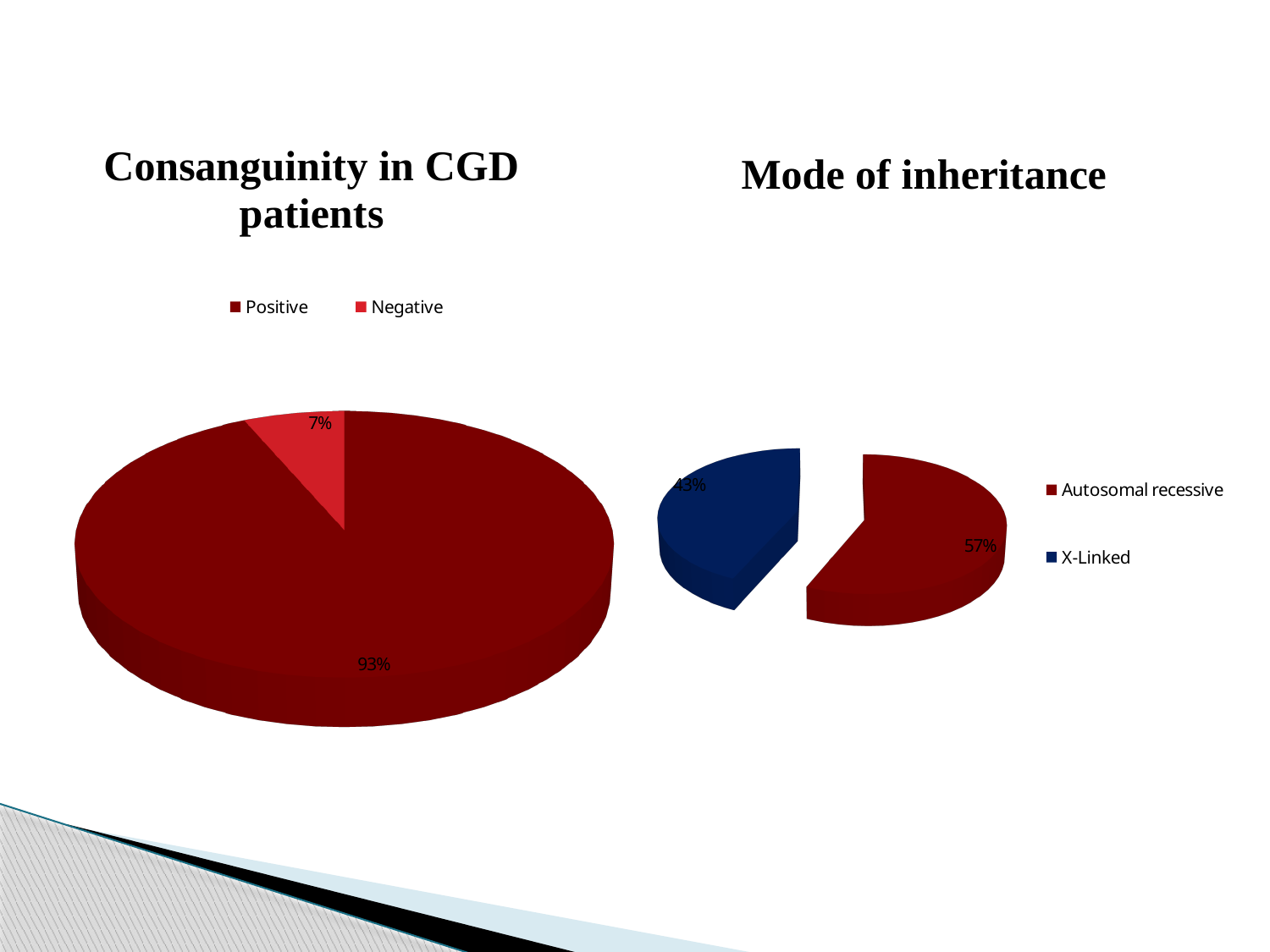
What type of chart is the 'Mode of inheritance' chart? Pie chart How many slices does the 'Consanguinity in CGD patients' chart have? 2 In the 'Consanguinity in CGD patients' chart, which category has the largest slice? Positive In the 'Mode of inheritance' chart, which is larger, Autosomal recessive or X-Linked? Autosomal recessive In the 'Consanguinity in CGD patients' chart, what percentage is labelled for Positive? 93% In the 'Mode of inheritance' chart, what percentage is labelled for X-Linked? 43% In the 'Consanguinity in CGD patients' chart, what percentage is labelled for Negative? 7% In the 'Mode of inheritance' chart, what percentage is labelled for Autosomal recessive? 57% In the 'Mode of inheritance' chart, what colour is the X-Linked slice? Dark blue In the 'Mode of inheritance' chart, which category has the smallest slice? X-Linked In the 'Mode of inheritance' chart, what is the difference in percentage points between Autosomal recessive and X-Linked? 14 In the 'Consanguinity in CGD patients' chart, what is the difference in percentage points between Positive and Negative? 86